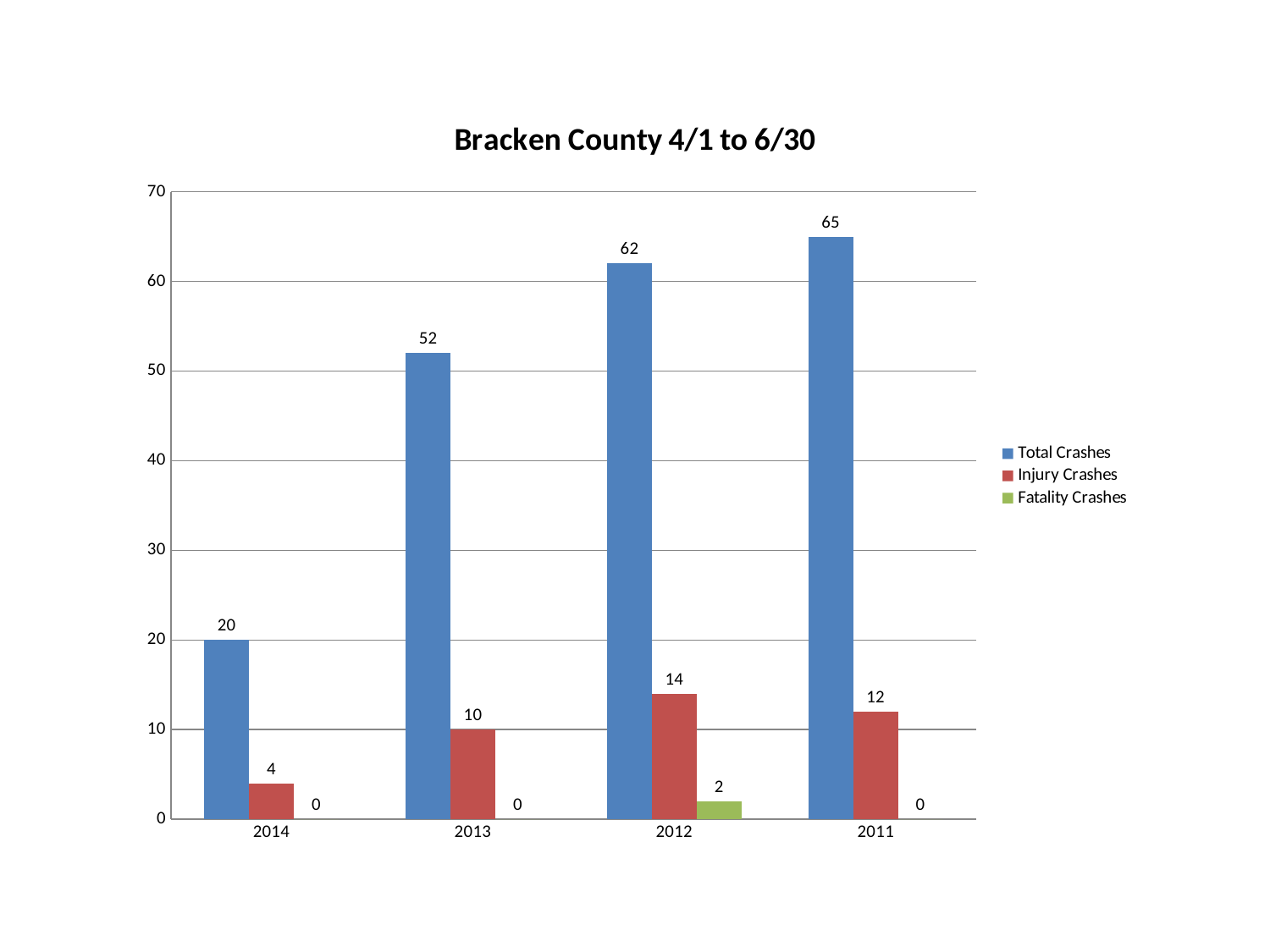
What is the value of Total Crashes for 2013? 52 What kind of chart is this? bar chart Which year has the highest Total Crashes? 2011 How many series does the legend list? 3 Which year has the lowest Injury Crashes? 2014 Which is larger, Injury Crashes in 2013 or Injury Crashes in 2011? 2011 What is the value of Fatality Crashes for 2012? 2 What is the title of the chart? Bracken County 4/1 to 6/30 What is the difference between Total Crashes in 2011 and 2014? 45 What is the value of Injury Crashes for 2012? 14 How many years are shown on the x axis? 4 Is the value for Total Crashes in 2012 greater or less than 60? greater